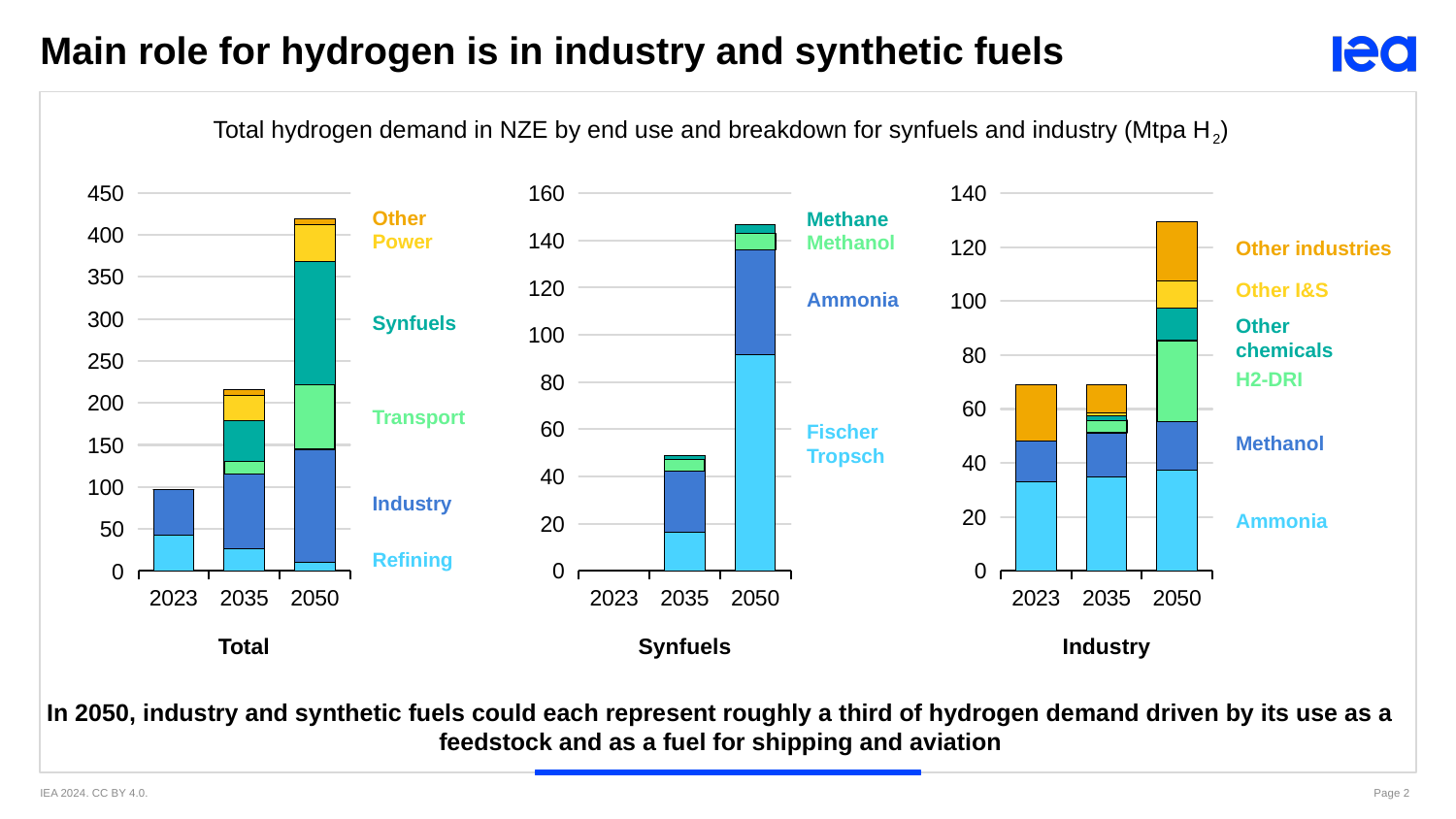
In the Industry chart, which is larger, the total for 2035 or the total for 2050? 2050 In the Synfuels chart, is the total for 2050 greater or less than 140? greater In the Total chart, how many end-use series are listed in the legend? 6 In the Synfuels chart, how many series are listed in the legend? 4 In the Total chart, is the total for 2023 greater or less than 150? less In the Industry chart, is the total for 2050 greater or less than 120? greater What kind of chart is used for the Industry panel? stacked bar chart In the Total chart, which year has the highest total hydrogen demand? 2050 In the Total chart, how many years are shown on the x axis? 3 In the Synfuels chart, which year has the lowest total? 2023 In the Total chart, does total hydrogen demand rise or fall from 2023 to 2050? rise